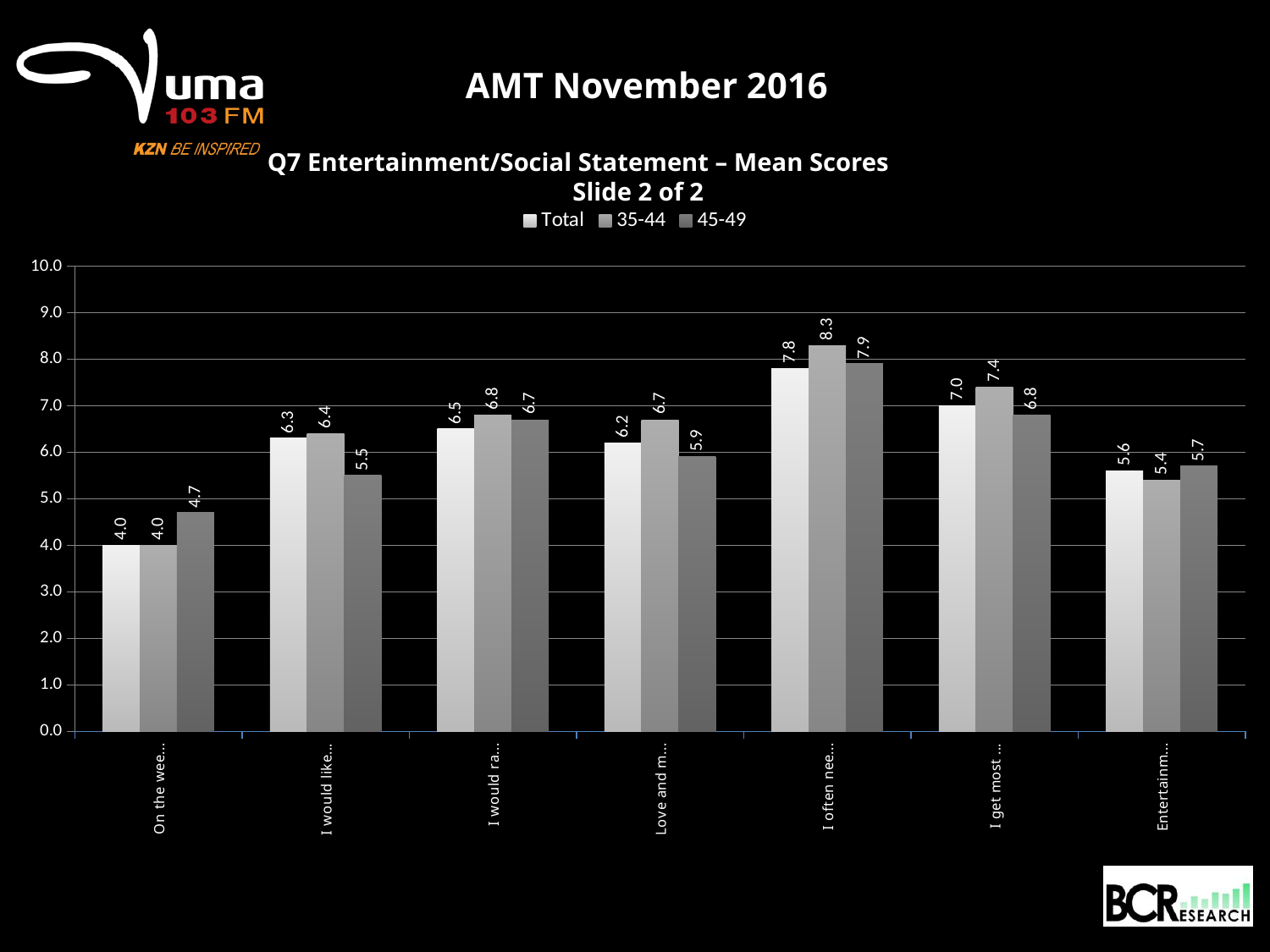
What is the difference between the Total mean scores for "I often nee..." and "I get most ..."? 0.8 For the category labelled "Entertainm...", which is larger: the Total score or the 45-49 score? 45-49 What are the three series listed in the legend? Total, 35-44, 45-49 How many categories are shown on the x axis? 7 What is the 35-44 mean score for the category labelled "Love and m..."? 6.7 Which category has the lowest Total mean score? On the wee... What is the difference between the 35-44 and 45-49 mean scores for the category labelled "I would like..."? 0.9 What is the Total mean score for the category labelled "I often nee..."? 7.8 Which category has the highest 35-44 mean score? I often nee... What kind of chart is shown on the slide? Bar chart What is the 45-49 mean score for the category labelled "On the wee..."? 4.7 How many series does the legend list? 3